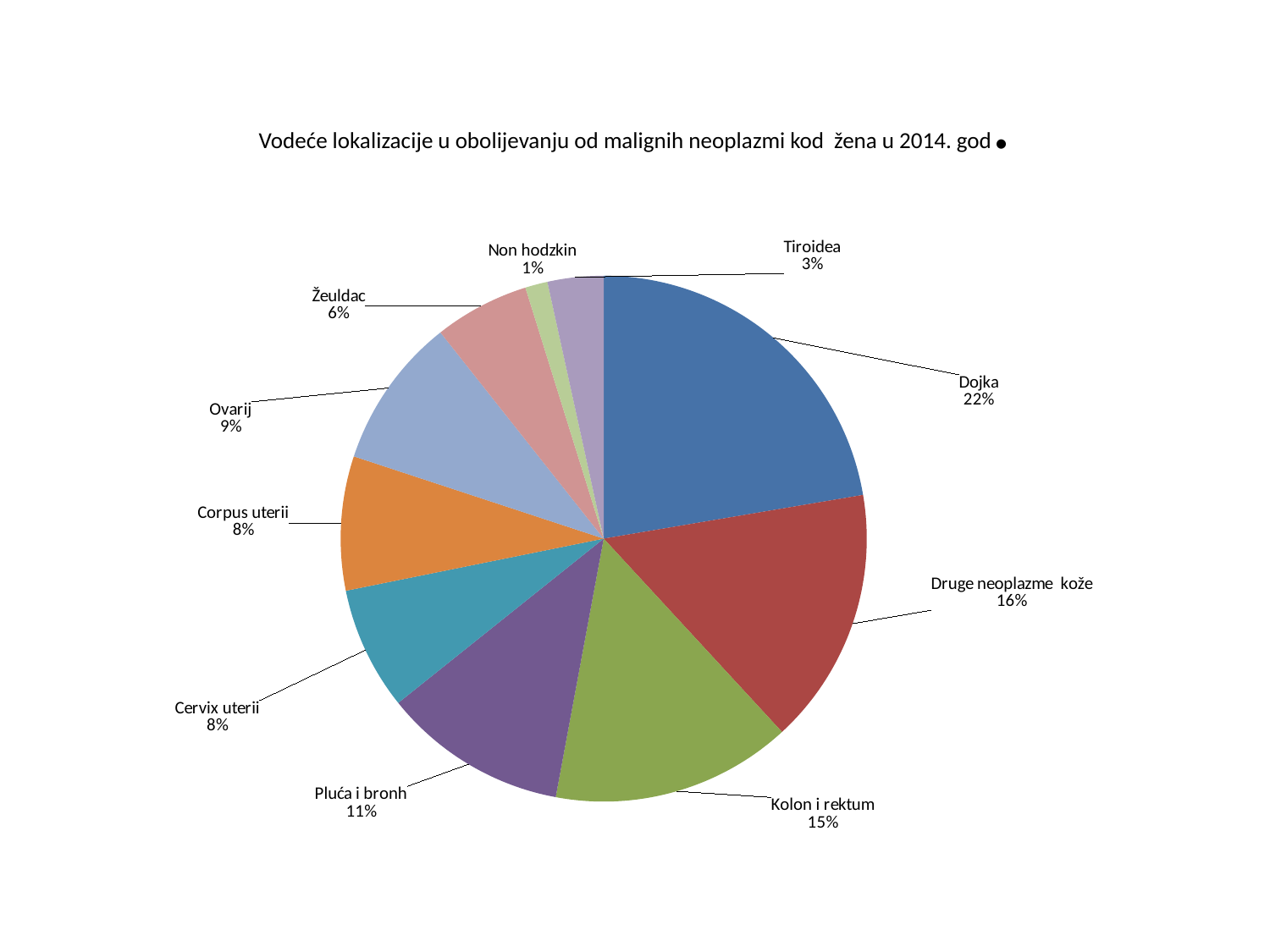
What is the value shown for Kolon i rektum? 15% What is the title of the chart? Vodeće lokalizacije u obolijevanju od malignih neoplazmi kod žena u 2014. god How many categories are shown in the pie chart? 10 Which category has the smallest slice of the pie? Non hodzkin What kind of chart is shown on the slide? Pie chart Which category has the largest slice of the pie? Dojka What share of the pie does Dojka represent? 22% What is the value shown for Tiroidea? 3% What is the difference between the shares of Dojka and Druge neoplazme kože? 6% What is the value shown for Želudac? 6% What is the combined share of Corpus uterii and Cervix uterii? 16% Which is larger, the share for Pluća i bronh or the share for Ovarij? Pluća i bronh